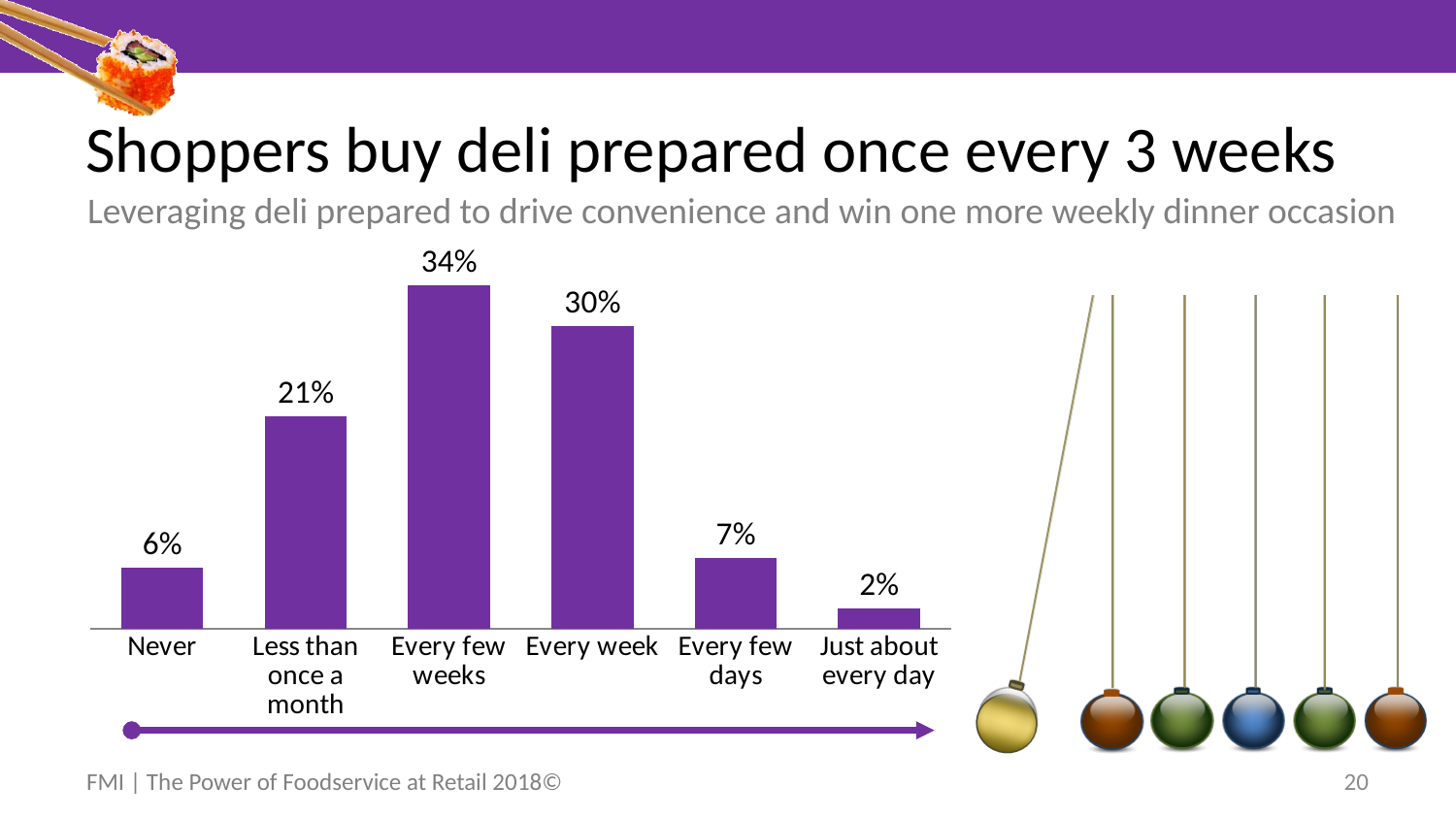
What kind of chart is shown on the slide? Bar chart What percentage of shoppers buy deli prepared every few weeks? 34% How many categories are shown in the chart? 6 Which category has the highest value? Every few weeks Which is larger, the value for 'Never' or the value for 'Every few days'? Every few days What colour are the bars in the chart? Purple What is the difference between the values for 'Less than once a month' and 'Every few days'? 14% What is the value for 'Just about every day'? 2% What is the value for the 'Never' category? 6% What is the difference between the values for 'Every few weeks' and 'Every week'? 4% Which category has the lowest value? Just about every day What percentage of shoppers buy deli prepared every week? 30%